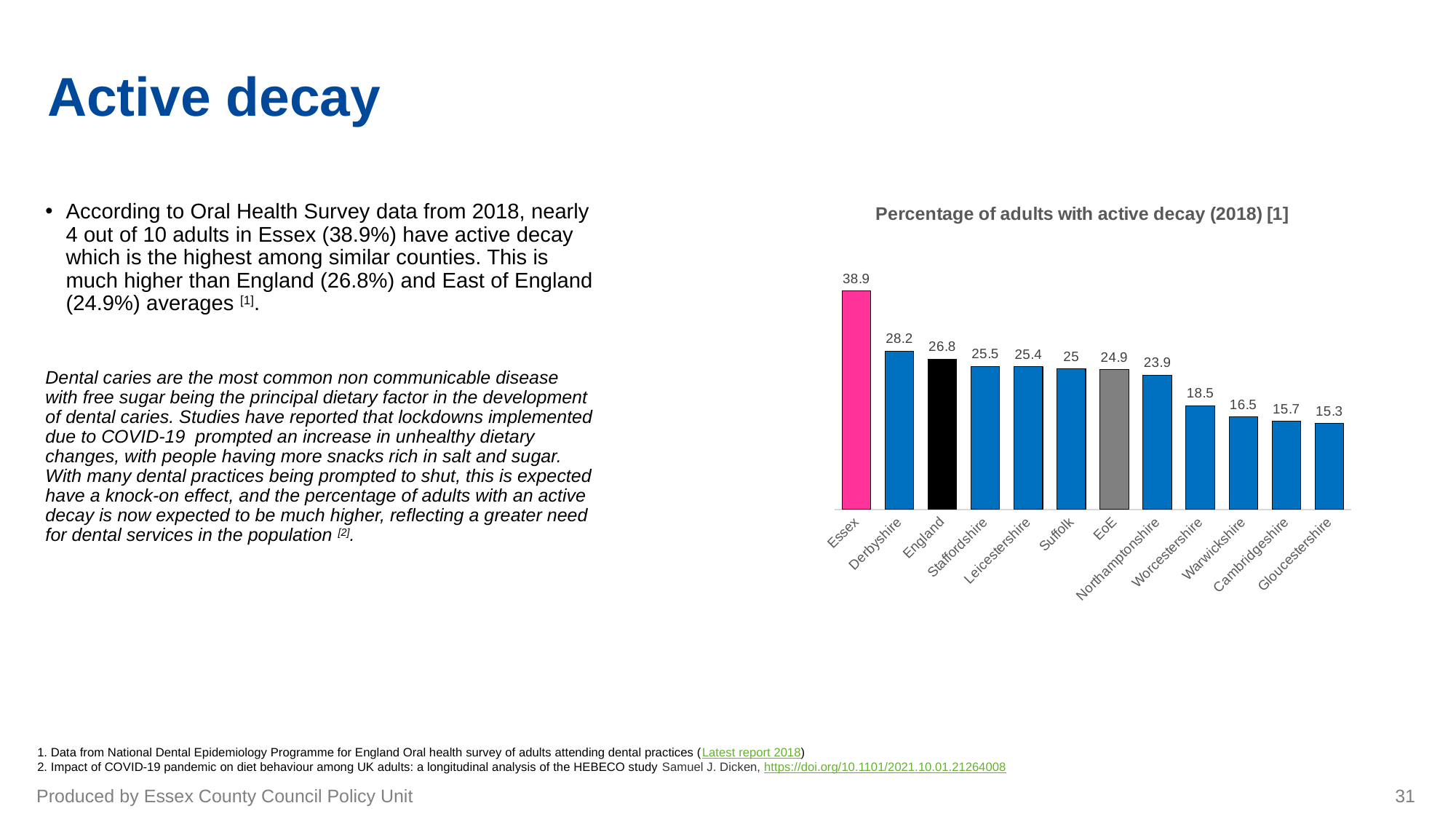
Which category has the highest value in the chart? Essex Which category has the lowest value in the chart? Gloucestershire What is the value for England in the chart? 26.8 What kind of chart is shown on the slide? Bar chart What is the difference between the values for Derbyshire and Northamptonshire? 4.3 How many categories are shown in the chart? 12 What is the difference between the values for Essex and England? 12.1 What is the value for EoE in the chart? 24.9 What is the value for Essex in the chart? 38.9 What is the title of the chart? Percentage of adults with active decay (2018) [1] Which has a larger value, Worcestershire or Warwickshire? Worcestershire What is the value for Gloucestershire in the chart? 15.3